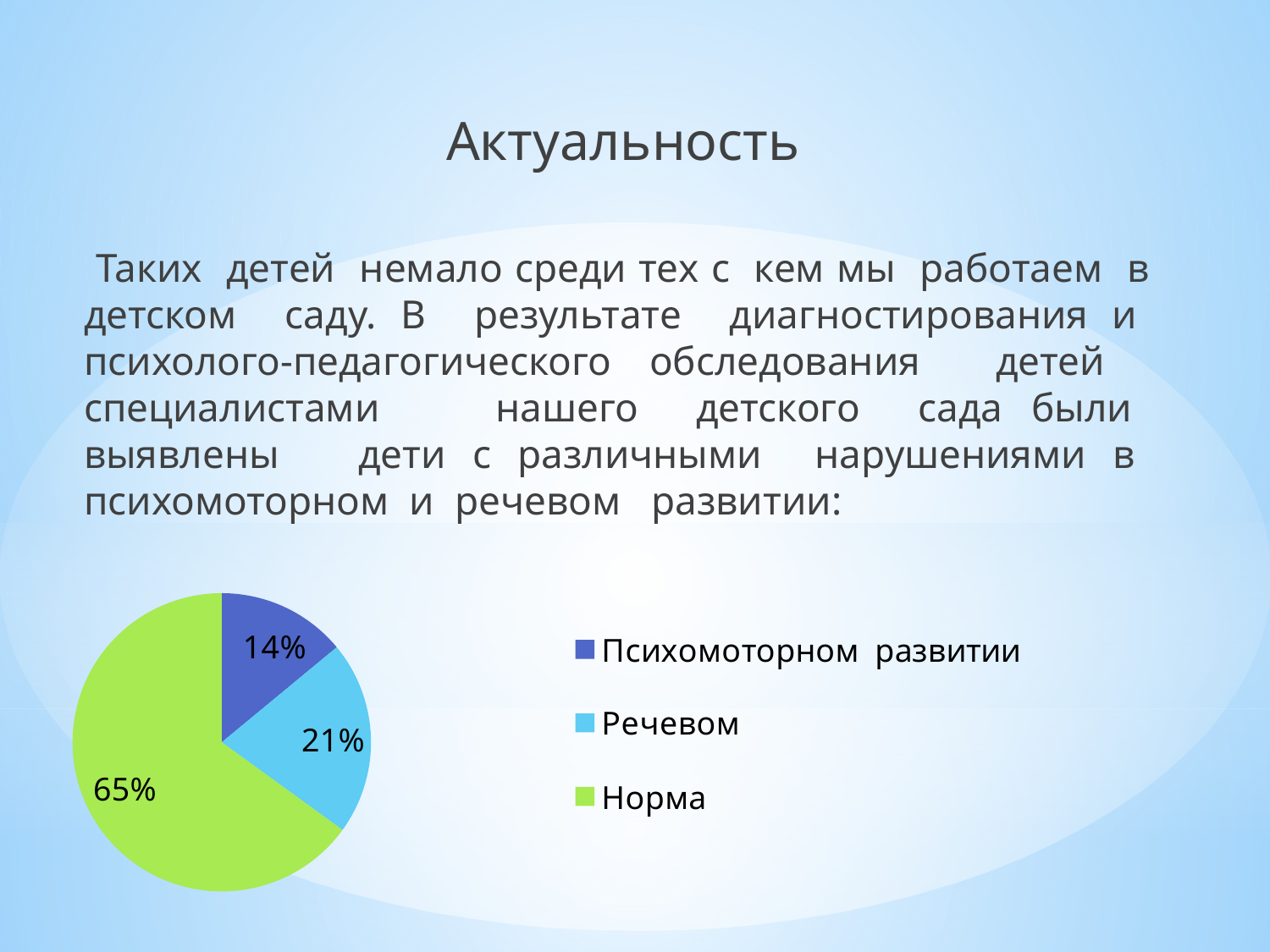
What share of the pie does "Психомоторном развитии" have? 14% How many entries does the legend list? 3 Which category has the largest slice of the pie? Норма What share of the pie does "Речевом" have? 21% Which is larger, the share for "Речевом" or for "Психомоторном развитии"? Речевом What is the difference between the shares for "Норма" and "Речевом"? 44% What kind of chart is shown on the slide? pie chart Which category has the smallest slice of the pie? Психомоторном развитии How many slices does the pie chart have? 3 What share of the pie does "Норма" have? 65% What colour is the slice for "Норма"? green What is the difference between the shares for "Речевом" and "Психомоторном развитии"? 7%